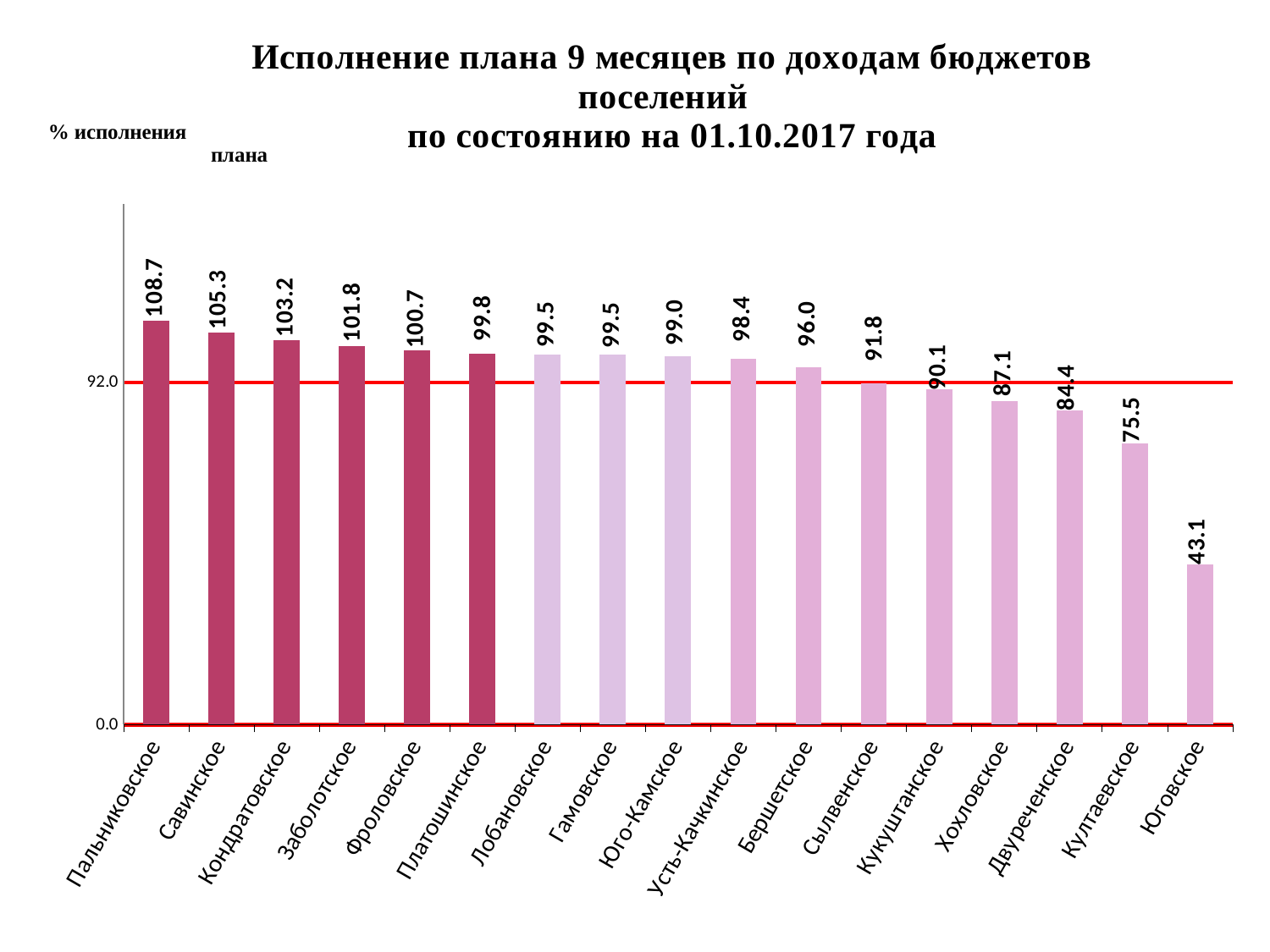
What is the difference between the values for Пальниковское and Савинское? 3.4 Which category has the lowest value? Юговское Is the value for Сылвенское greater or less than 92.0? less What is the difference between the values for Култаевское and Юговское? 32.4 Which is larger, the value for Хохловское or the value for Двуреченское? Хохловское What kind of chart is shown on the slide? bar chart How many categories are shown on the x axis? 17 What is the value for Кукуштанское? 90.1 What is the value for Юговское? 43.1 Which category has the highest value? Пальниковское What is the value for Пальниковское? 108.7 What is the value for Бершетское? 96.0